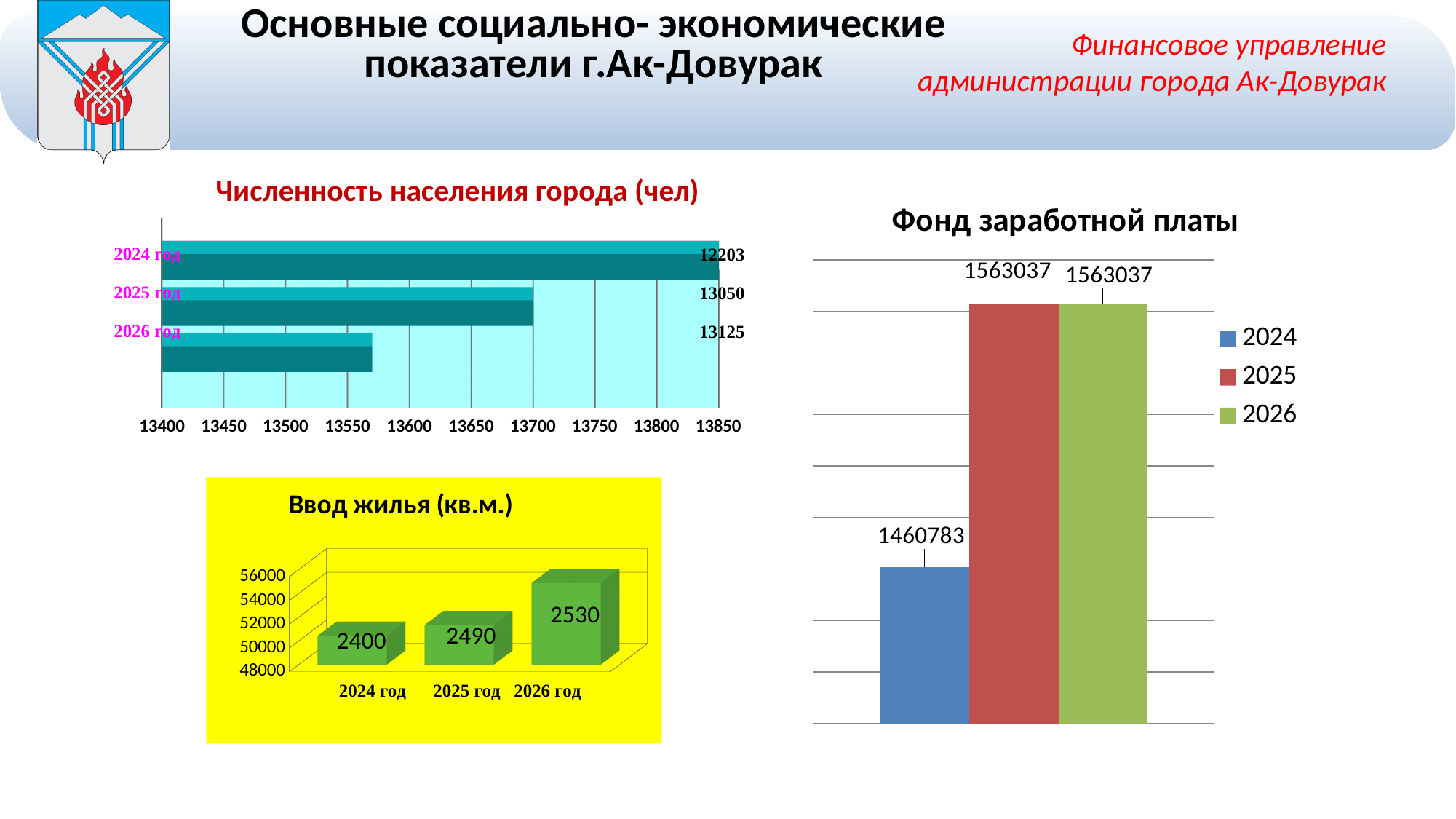
In the chart titled "Фонд заработной платы", what is the value for 2024? 1460783 In the chart titled "Численность населения города (чел)", how many categories are shown? 3 What kind of chart is "Численность населения города (чел)"? Bar chart In the chart titled "Численность населения города (чел)", what value is labelled for 2024 год? 12203 In the chart titled "Ввод жилья (кв.м.)", what is the value for 2025 год? 2490 In the chart titled "Фонд заработной платы", what is the difference between the values for 2025 and 2024? 102254 In the chart titled "Ввод жилья (кв.м.)", what is the difference between the values for 2026 год and 2024 год? 130 In the chart titled "Численность населения города (чел)", what value is labelled for 2026 год? 13125 In the chart titled "Фонд заработной платы", which year has the lowest value? 2024 In the chart titled "Ввод жилья (кв.м.)", which year has the highest value? 2026 год In the chart titled "Фонд заработной платы", how many entries does the legend list? 3 In the chart titled "Ввод жилья (кв.м.)", do the values rise or fall from 2024 год to 2026 год? Rise